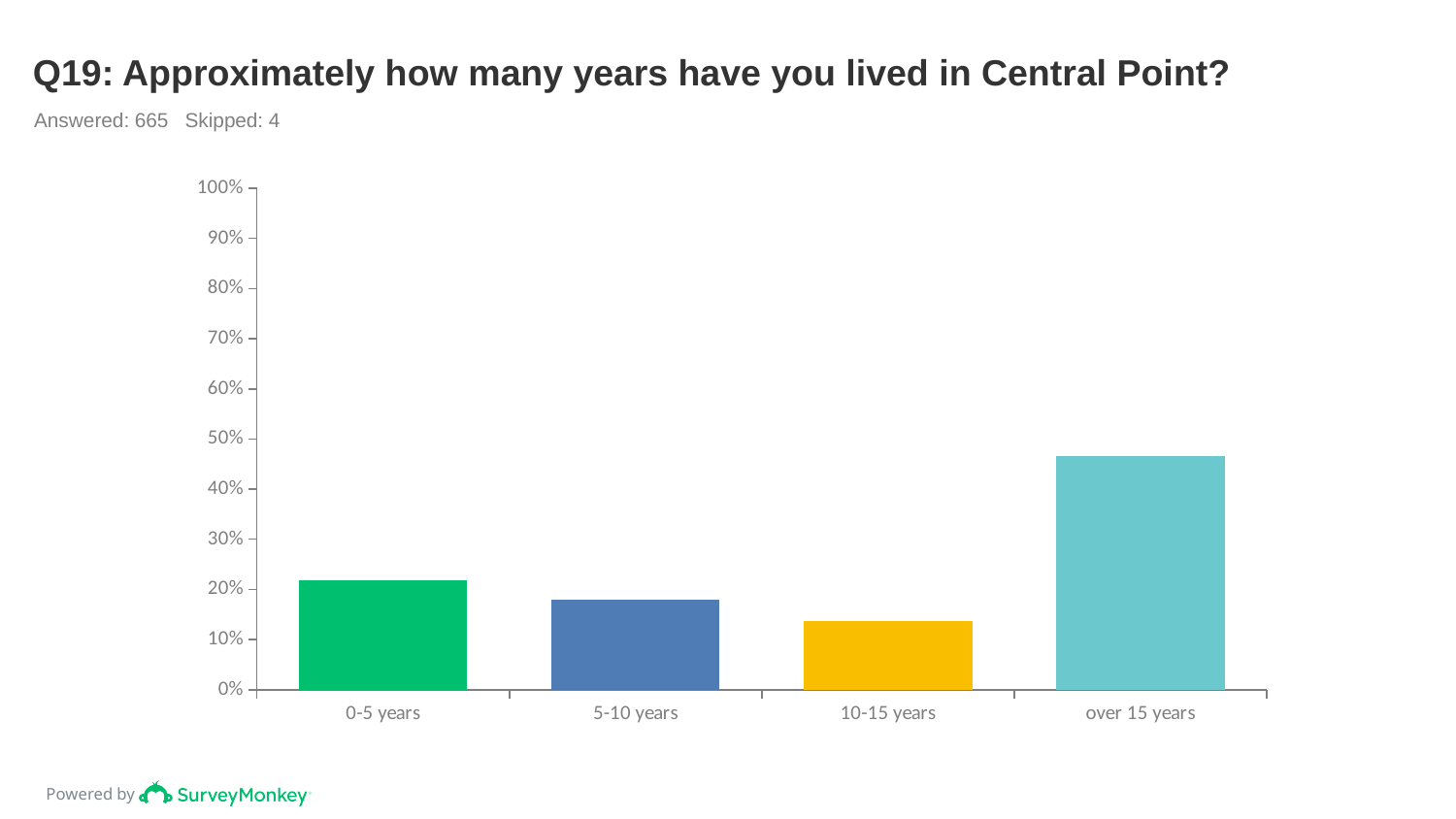
Is the value for 10-15 years greater or less than 10%? greater Is the value for over 15 years greater or less than 50%? less What is the title of the chart on the slide? Q19: Approximately how many years have you lived in Central Point? How many categories are shown on the x axis of the chart? 4 What kind of chart is shown on the slide? bar chart Which is larger, the value for 0-5 years or the value for 5-10 years? 0-5 years Which category has the highest value in the chart? over 15 years How many respondents answered the question according to the slide? 665 Is the value for over 15 years greater or less than 40%? greater Which category has the lowest value in the chart? 10-15 years